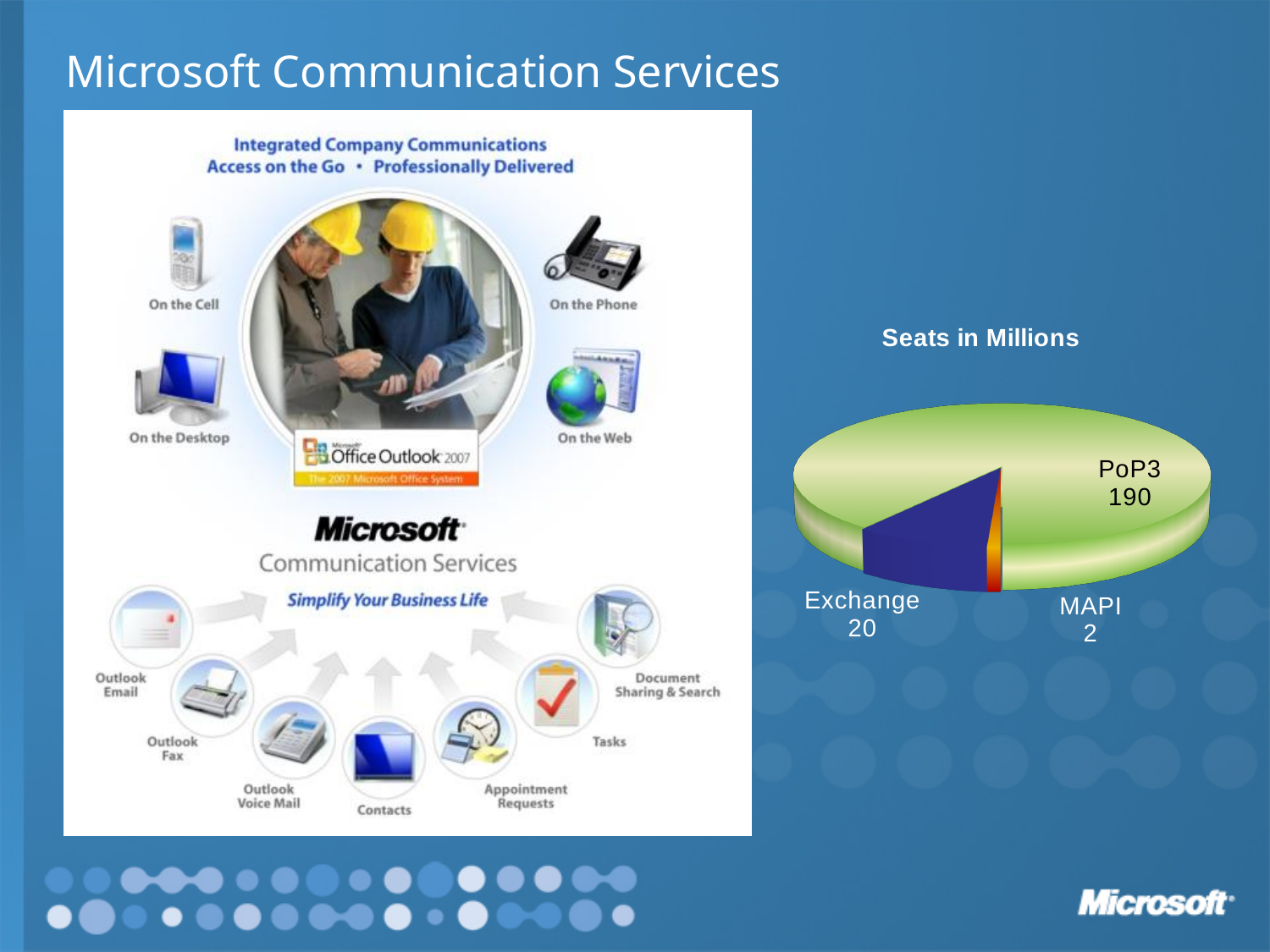
How many categories are shown in the "Seats in Millions" pie chart? 3 What kind of chart is shown under the title "Seats in Millions"? Pie chart In the "Seats in Millions" pie chart, what is the difference between the PoP3 and Exchange values? 170 Which category has the largest slice in the "Seats in Millions" pie chart? PoP3 Which category has the smallest slice in the "Seats in Millions" pie chart? MAPI In the "Seats in Millions" pie chart, which is larger, Exchange or MAPI? Exchange In the "Seats in Millions" pie chart, what is the value for MAPI? 2 In the "Seats in Millions" pie chart, what is the value for Exchange? 20 In the "Seats in Millions" pie chart, what is the value for PoP3? 190 What is the total of all slices in the "Seats in Millions" pie chart? 212 What is the title of the pie chart on the slide? Seats in Millions In the "Seats in Millions" pie chart, what is the difference between the Exchange and MAPI values? 18